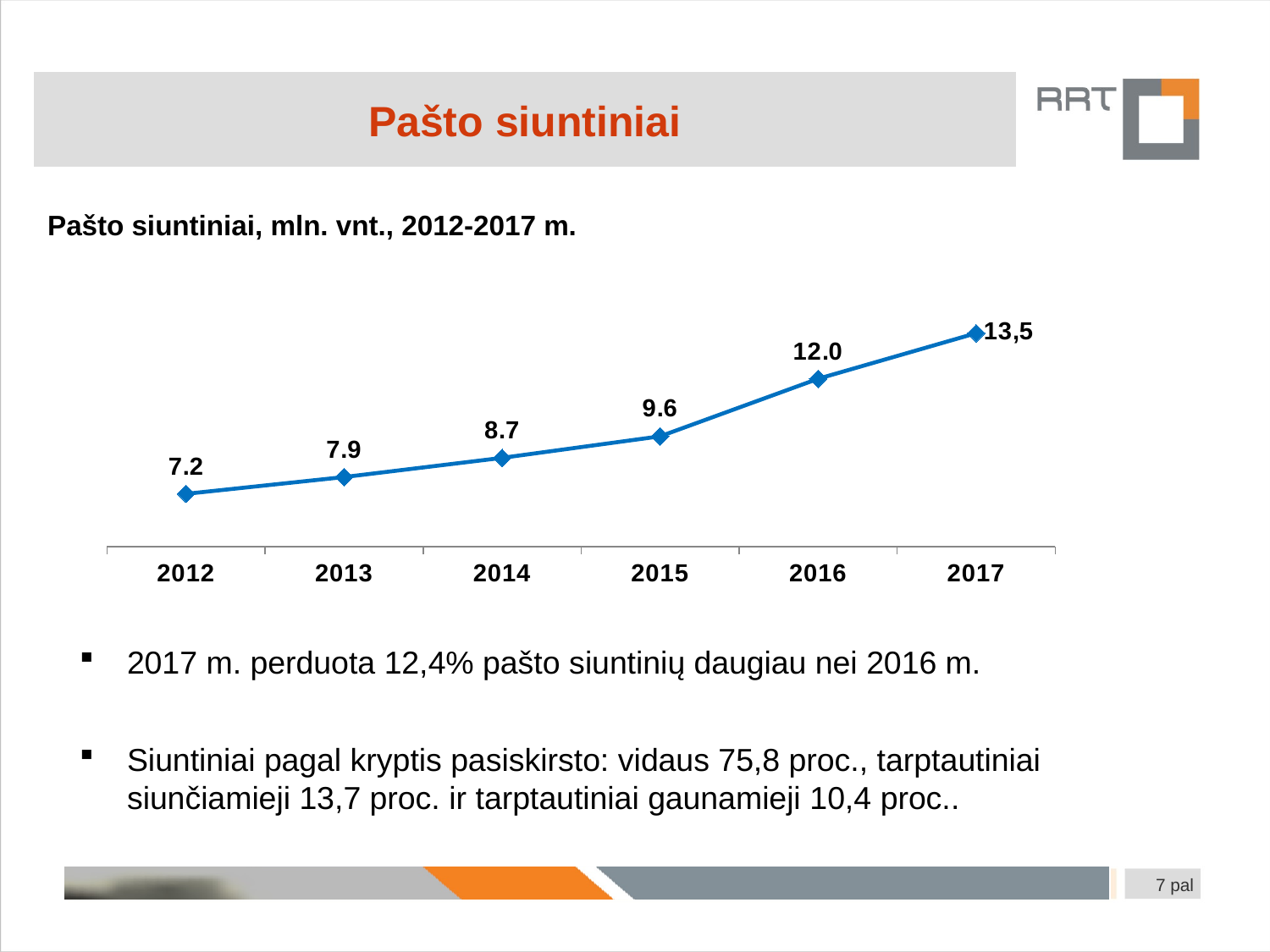
Do the values rise or fall from 2012 to 2017? rise What is the difference between the values for 2014 and 2013? 0.8 Which year has the highest value? 2017 What is the difference between the values for 2016 and 2015? 2.4 Which is larger, the value for 2014 or the value for 2016? 2016 Which year has the lowest value? 2012 What is the value for 2016? 12.0 What is the value for 2012? 7.2 What is the value for 2017? 13,5 What is the value for 2015? 9.6 What kind of chart is this? line chart How many years are shown on the x axis? 6